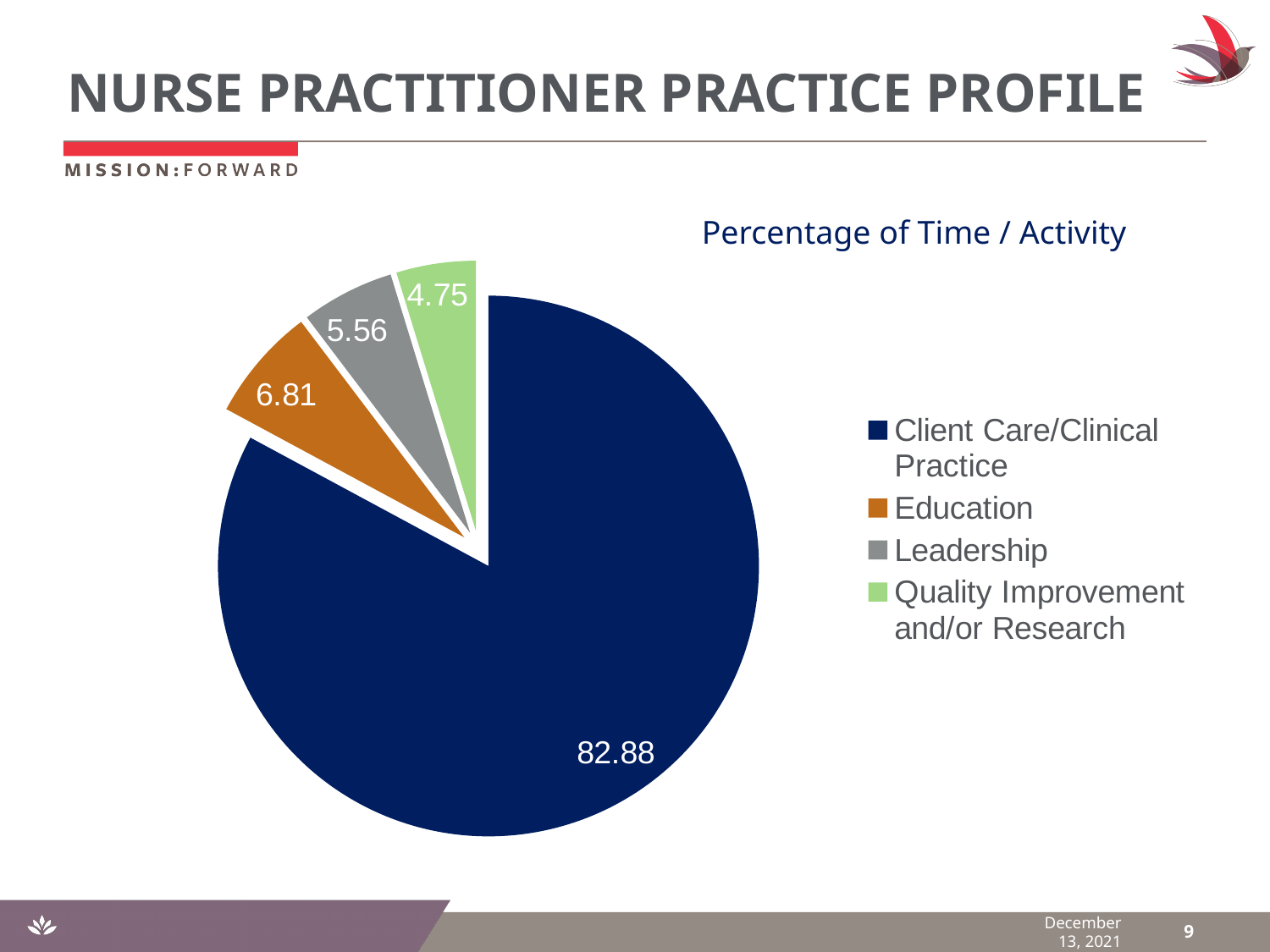
What colour is the Education slice? orange What is the difference between the values for Education and Leadership? 1.25 What is the value for Leadership? 5.56 What is the value for Quality Improvement and/or Research? 4.75 What type of chart is shown on the slide? pie chart How many categories does the legend list? 4 What is the value for Client Care/Clinical Practice? 82.88 What is the chart's title? Percentage of Time / Activity What is the value for Education? 6.81 Which category has the largest slice? Client Care/Clinical Practice Which is larger, the value for Leadership or the value for Quality Improvement and/or Research? Leadership Which category has the smallest slice? Quality Improvement and/or Research